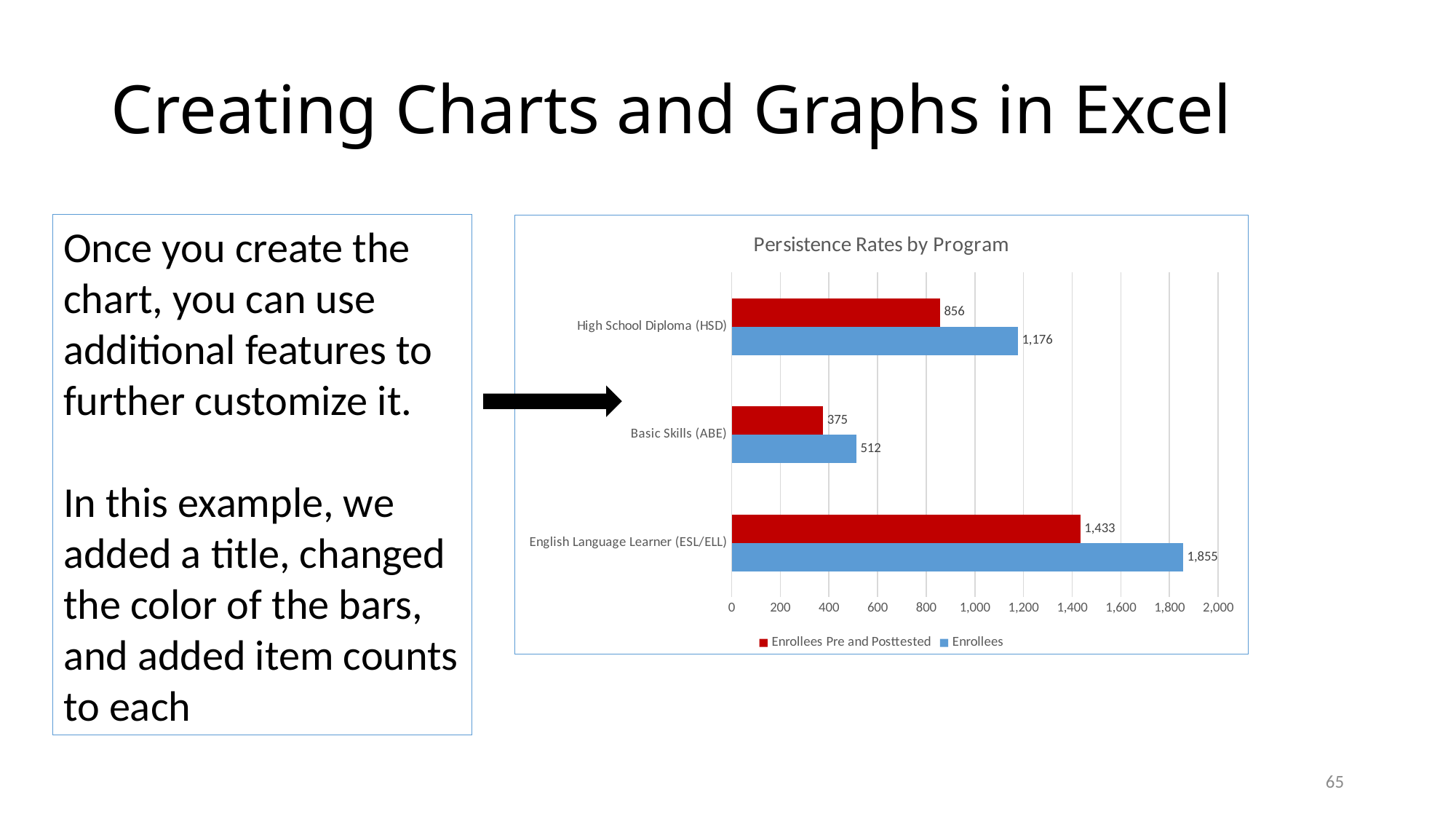
What is the difference between Enrollees and Enrollees Pre and Posttested for High School Diploma (HSD)? 320 Which program has the highest number of Enrollees? English Language Learner (ESL/ELL) How many program categories are shown on the chart? 3 Which colour represents the Enrollees series? blue Which program has the lowest number of Enrollees Pre and Posttested? Basic Skills (ABE) What is the Enrollees value for English Language Learner (ESL/ELL)? 1,855 What is the Enrollees value for High School Diploma (HSD)? 1,176 Which is larger: Enrollees Pre and Posttested for English Language Learner (ESL/ELL) or Enrollees for High School Diploma (HSD)? Enrollees Pre and Posttested for English Language Learner (ESL/ELL) What kind of chart is shown on the slide? bar chart What is the Enrollees Pre and Posttested value for Basic Skills (ABE)? 375 What is the title of the chart? Persistence Rates by Program How many series does the legend list? 2